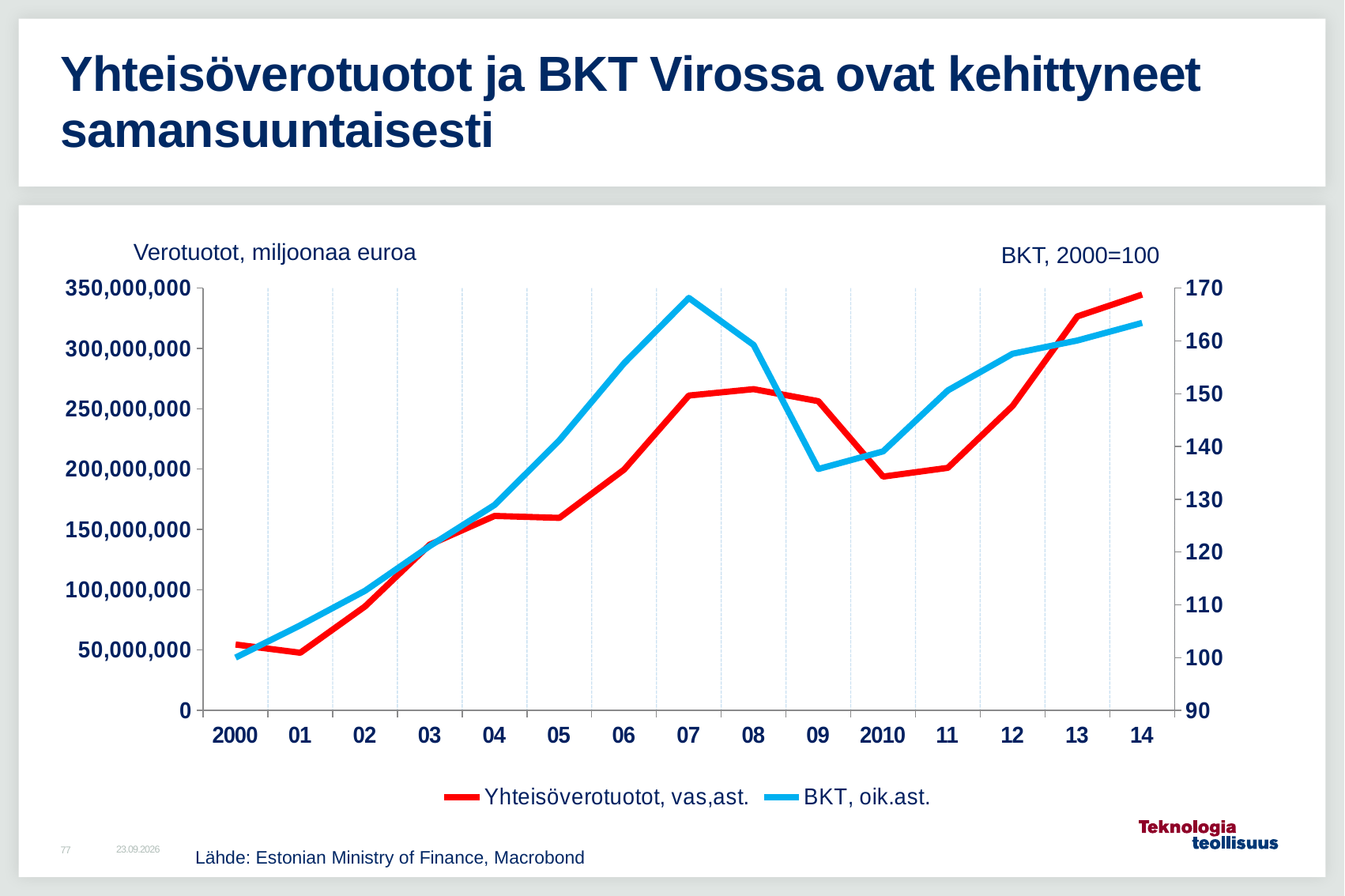
Is the Yhteisöverotuotot value for 13 greater or less than 300,000,000? greater What is the label shown above the left axis? Verotuotot, miljoonaa euroa In which year does the BKT series peak? 07 In which year does the Yhteisöverotuotot series reach its highest value? 14 What kind of chart is shown on the slide? line chart In which year is the BKT series at its lowest? 2000 How many years are plotted along the x axis? 15 In which year is the Yhteisöverotuotot series at its lowest? 01 How many series does the legend list? 2 Which is larger for the BKT series: the value in 08 or the value in 09? 08 Does the Yhteisöverotuotot series rise or fall from 2010 to 14? rise Is the BKT value for 09 greater or less than 140? less